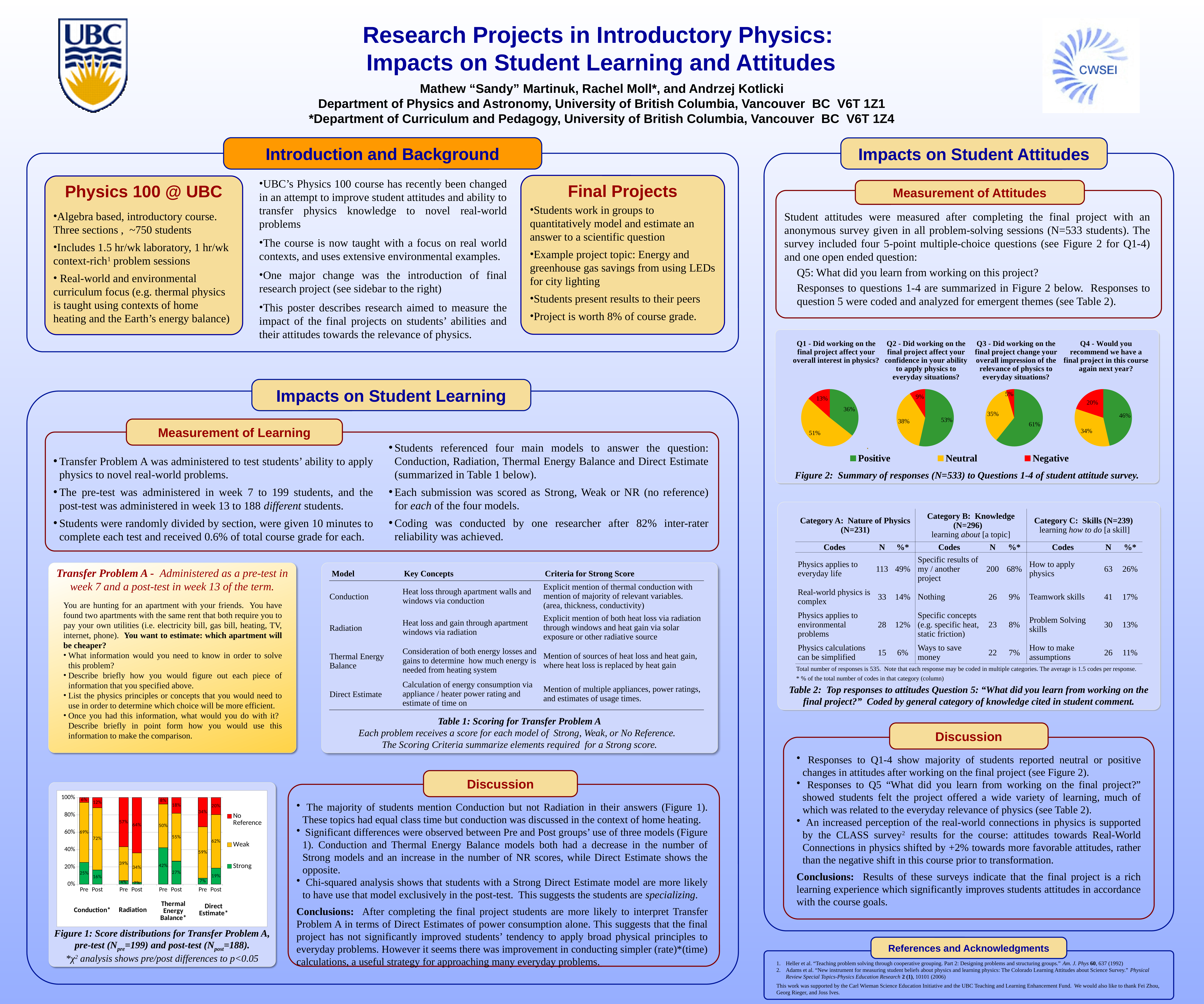
In Figure 1, by how many percentage points did the Strong share for Thermal Energy Balance drop from pre-test (42%) to post-test (27%)? 15 percentage points In Figure 2, what percentage of responses to Q1 were Neutral? 51% In Figure 2, what percentage of responses to Q4 were Negative? 20% What kind of chart is Figure 1? Stacked bar chart In Figure 2, what percentage of responses to Q3 were Positive? 61% In Figure 2, which question has the largest Negative share? Q4 In Figure 1, what percentage of Conduction pre-test scores were Weak? 69% In Figure 1, what percentage of Direct Estimate post-test scores were Strong? 19% In Figure 2, how many response categories does the legend list? 3 In Figure 2, for Q2, is the Positive share or the Neutral share larger? Positive In Figure 2, which question has the largest Positive share? Q3 In Figure 1, how many models are shown along the x axis? 4